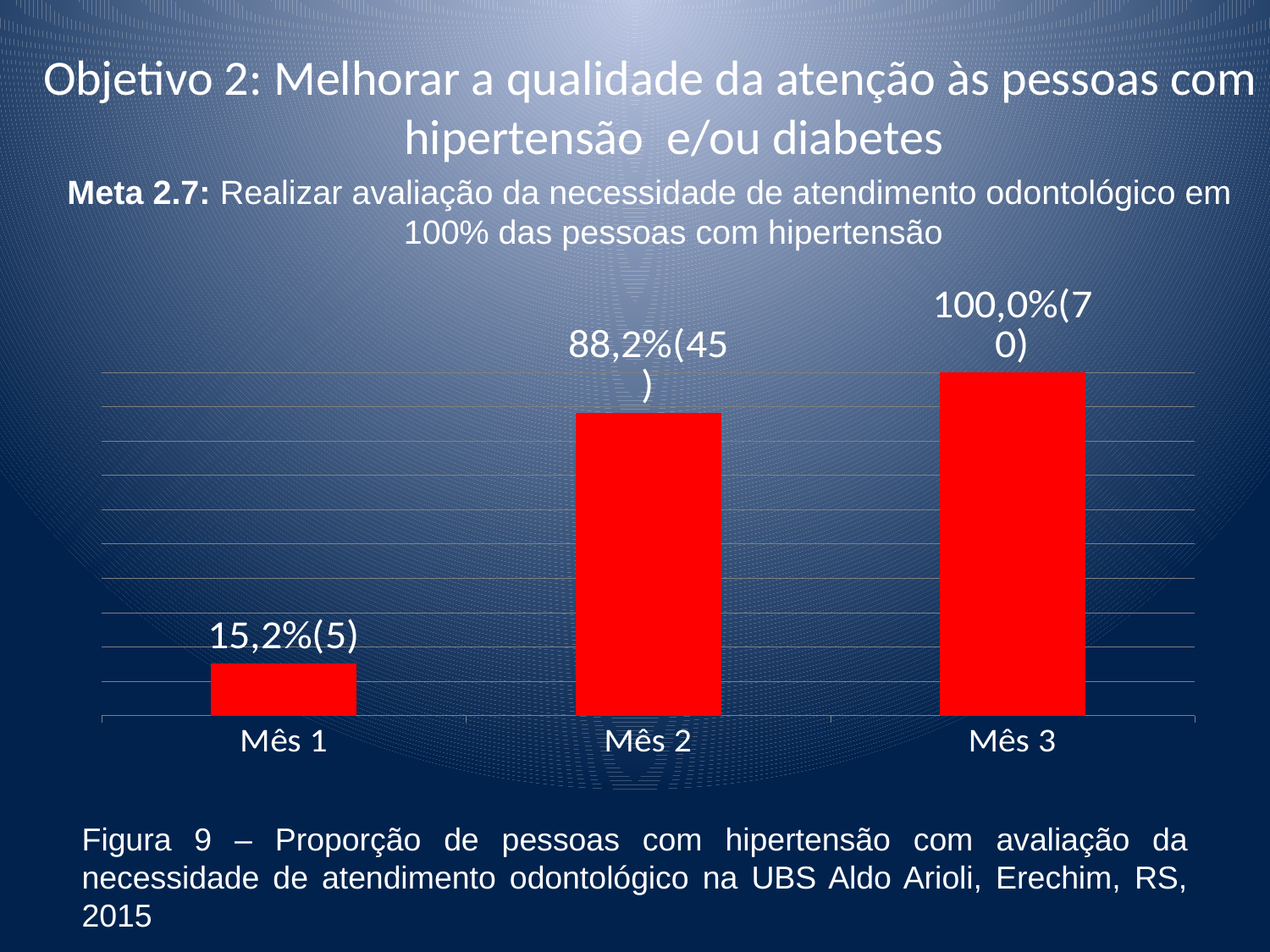
What is the value shown for Mês 3? 100,0%(70) What is the difference in percentage between Mês 2 and Mês 1? 73,0% What is the difference in percentage between Mês 3 and Mês 2? 11,8% How many months (categories) are shown in the chart? 3 What is the value shown for Mês 2? 88,2%(45) Which month has the highest value? Mês 3 What colour are the bars in the chart? Red Which month has the lowest value? Mês 1 Do the values rise or fall from Mês 1 to Mês 3? Rise What is the value shown for Mês 1? 15,2%(5) What kind of chart is shown on the slide? Bar chart Which is larger, the value for Mês 1 or the value for Mês 2? Mês 2